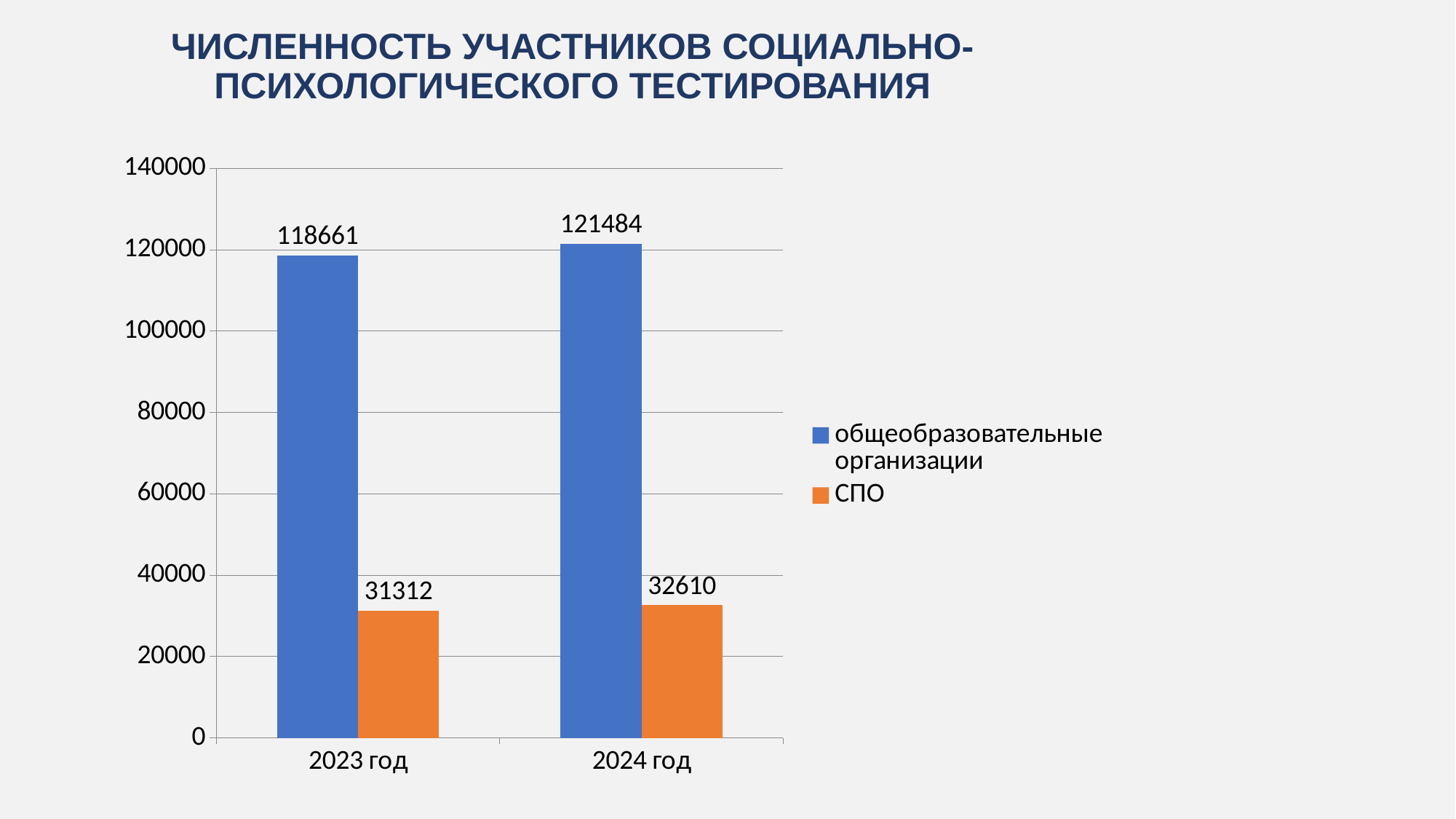
What is the value for СПО in 2024 год? 32610 Which is larger in 2023 год: общеобразовательные организации or СПО? общеобразовательные организации How many series does the legend list? 2 Which year has the higher value for общеобразовательные организации? 2024 год What is the value for общеобразовательные организации in 2023 год? 118661 Is the value for общеобразовательные организации in 2024 год greater or less than 120000? greater What is the difference between общеобразовательные организации and СПО in 2024 год? 88874 What is the value for СПО in 2023 год? 31312 Which year has the lower value for СПО? 2023 год What kind of chart is shown on the slide? bar chart By how much did the value for общеобразовательные организации change from 2023 год to 2024 год? 2823 Does the value for СПО rise or fall from 2023 год to 2024 год? rise